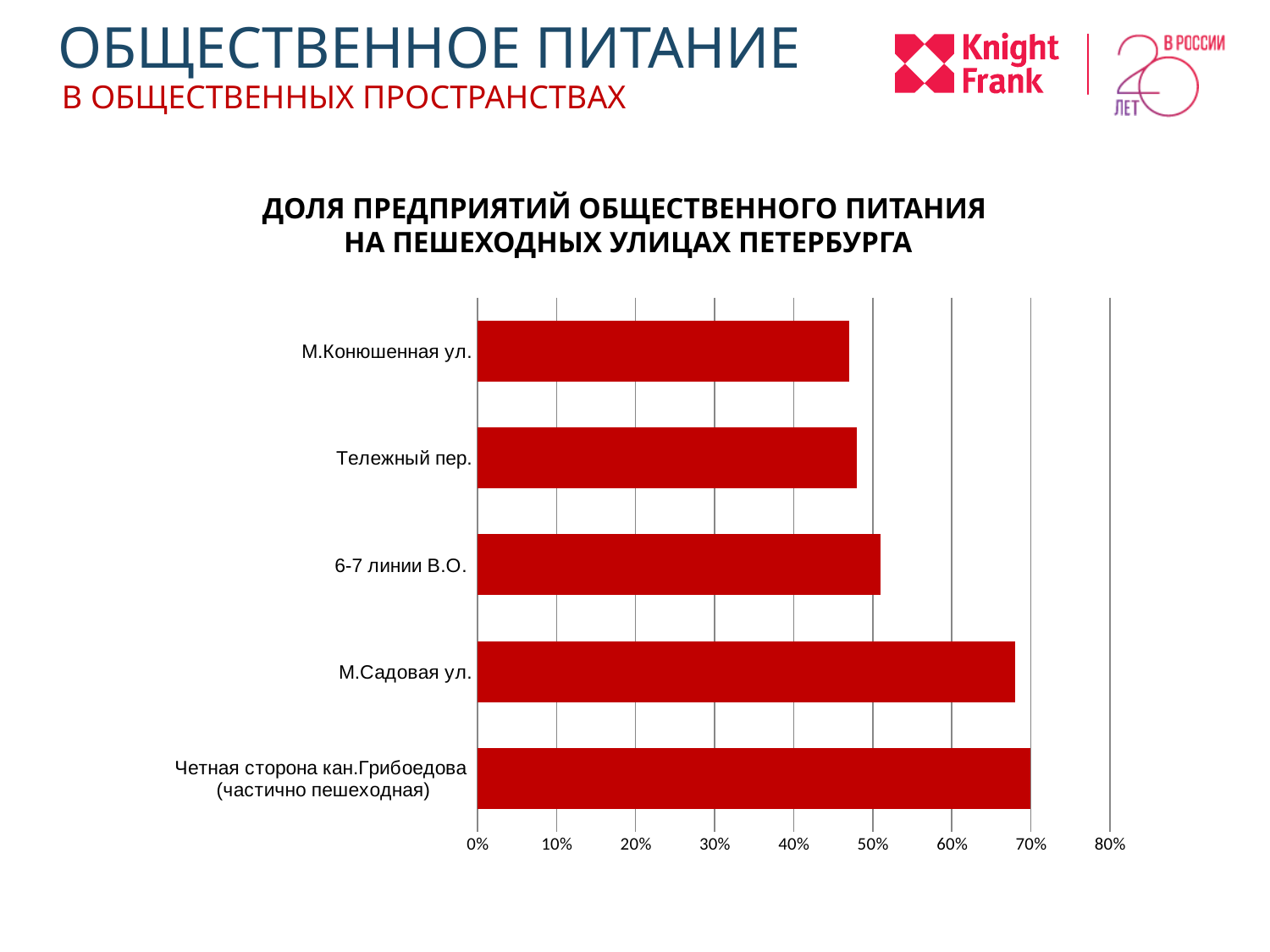
Is the value for Четная сторона кан.Грибоедова (частично пешеходная) greater or less than 60%? greater How many streets (categories) are plotted in the chart? 5 Which has the larger value: 6-7 линии В.О. or М.Садовая ул.? М.Садовая ул. What is the title of the chart? ДОЛЯ ПРЕДПРИЯТИЙ ОБЩЕСТВЕННОГО ПИТАНИЯ НА ПЕШЕХОДНЫХ УЛИЦАХ ПЕТЕРБУРГА What is the highest value shown on the horizontal axis of the chart? 80% Is the value for М.Конюшенная ул. greater or less than 50%? less Which has the larger value: Четная сторона кан.Грибоедова (частично пешеходная) or Тележный пер.? Четная сторона кан.Грибоедова (частично пешеходная) Is the value for 6-7 линии В.О. greater or less than 40%? greater Which has the larger value: М.Садовая ул. or М.Конюшенная ул.? М.Садовая ул. What kind of chart is shown on the slide? bar chart